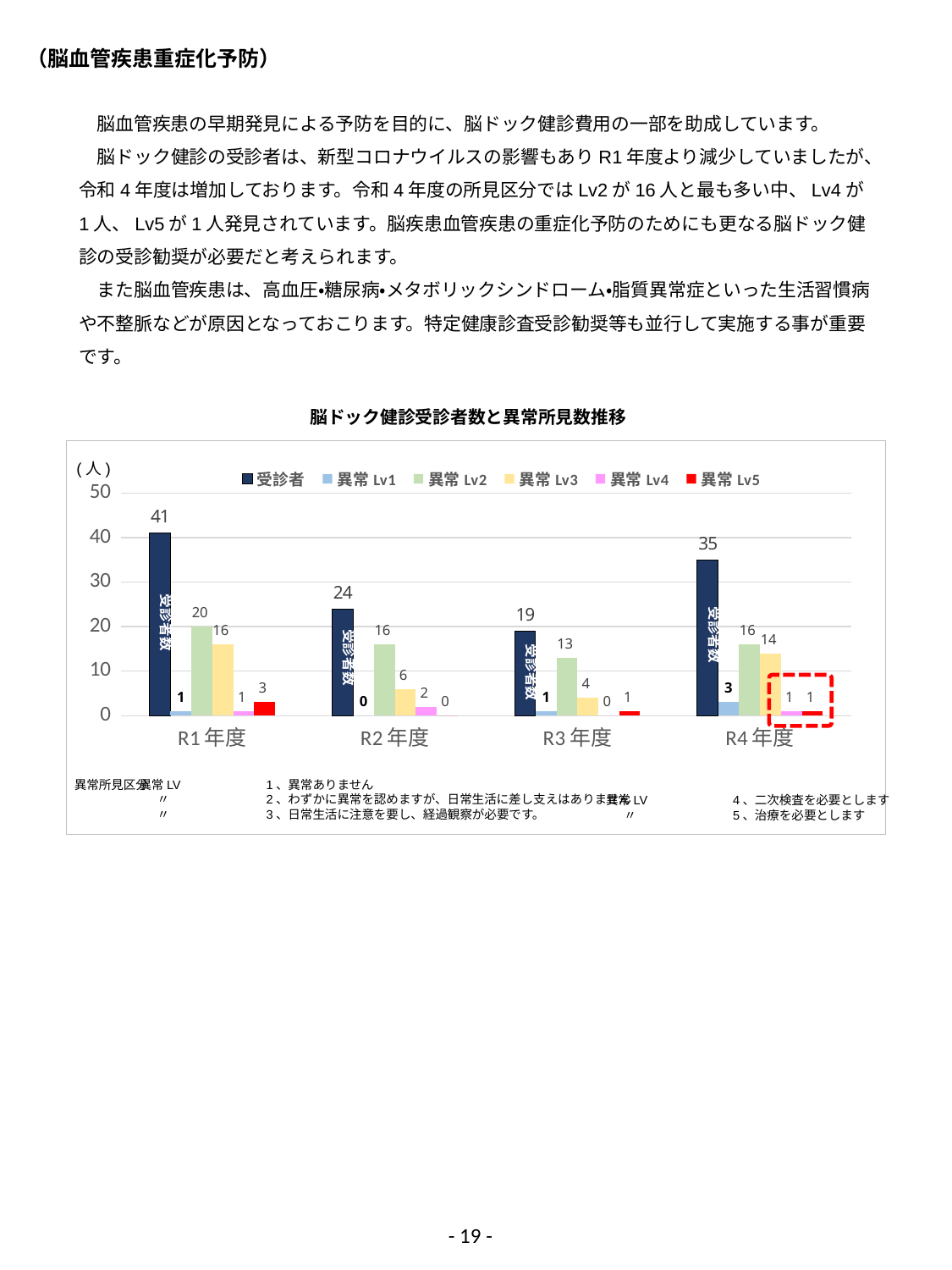
What is the value of 受診者 for R1年度? 41 What kind of chart is this? Bar chart How many years (categories) are shown on the x axis? 4 Which year has the highest 受診者 value? R1年度 Which year has the lowest 受診者 value? R3年度 What is the title of the chart? 脳ドック健診受診者数と異常所見数推移 What is the value of 異常Lv5 for R1年度? 3 What is the value of 異常Lv3 for R2年度? 6 What is the value of 異常Lv2 for R4年度? 16 What is the difference between the 受診者 values for R4年度 and R3年度? 16 How many series does the legend list? 6 Which is larger, 異常Lv2 for R1年度 or 異常Lv2 for R2年度? 異常Lv2 for R1年度